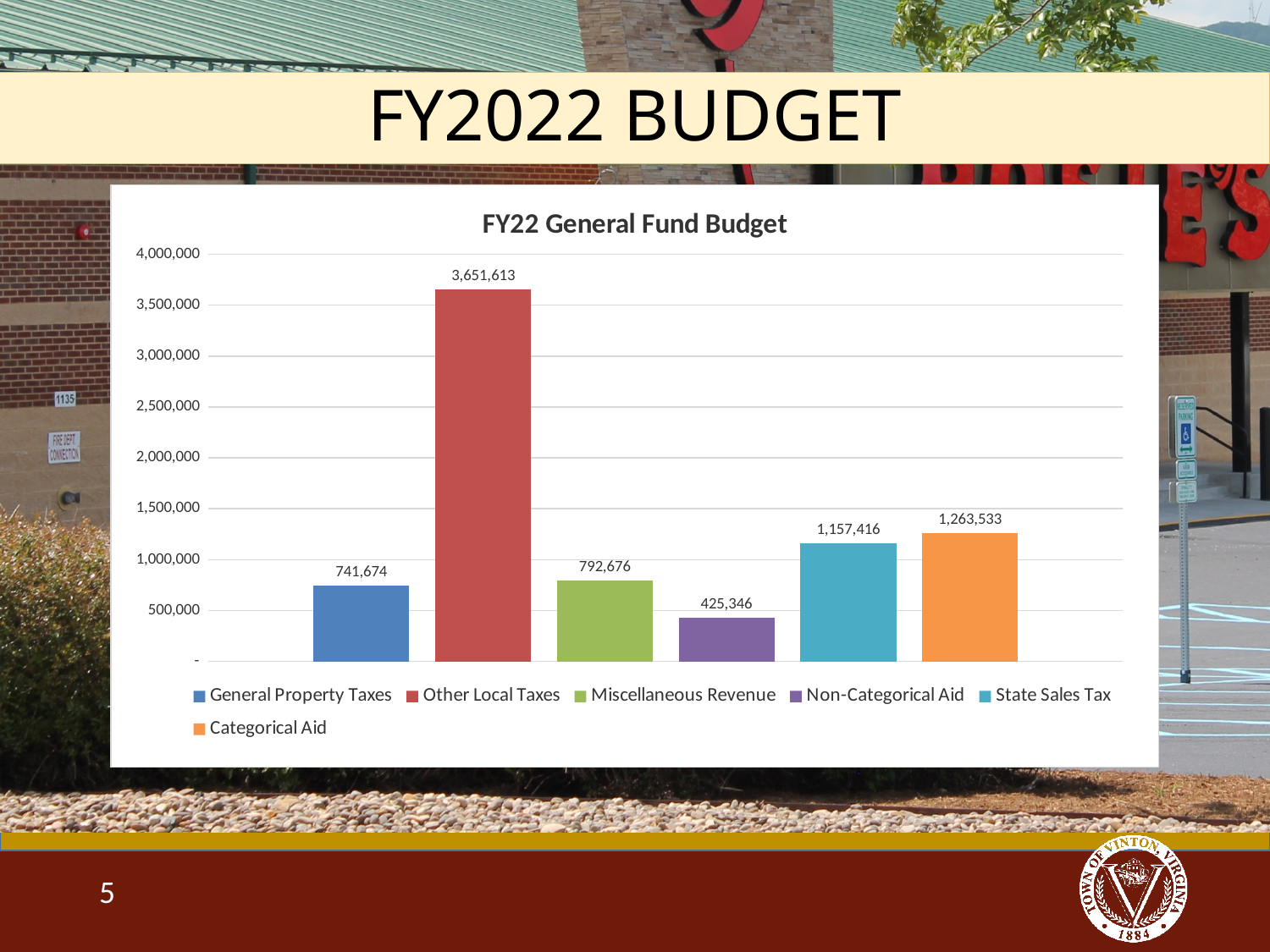
Is the value for Other Local Taxes greater or less than 3,500,000? greater How many series does the legend list in the FY22 General Fund Budget chart? 6 What is the value for Non-Categorical Aid in the FY22 General Fund Budget chart? 425,346 What is the value for State Sales Tax in the FY22 General Fund Budget chart? 1,157,416 What is the difference between Categorical Aid and State Sales Tax in the FY22 General Fund Budget chart? 106,117 Which category has the highest value in the FY22 General Fund Budget chart? Other Local Taxes What kind of chart is the FY22 General Fund Budget chart? Bar chart Which is larger in the FY22 General Fund Budget chart, Categorical Aid or State Sales Tax? Categorical Aid Which category has the lowest value in the FY22 General Fund Budget chart? Non-Categorical Aid What is the value for Other Local Taxes in the FY22 General Fund Budget chart? 3,651,613 What is the difference between Miscellaneous Revenue and General Property Taxes in the FY22 General Fund Budget chart? 51,002 What is the value for General Property Taxes in the FY22 General Fund Budget chart? 741,674